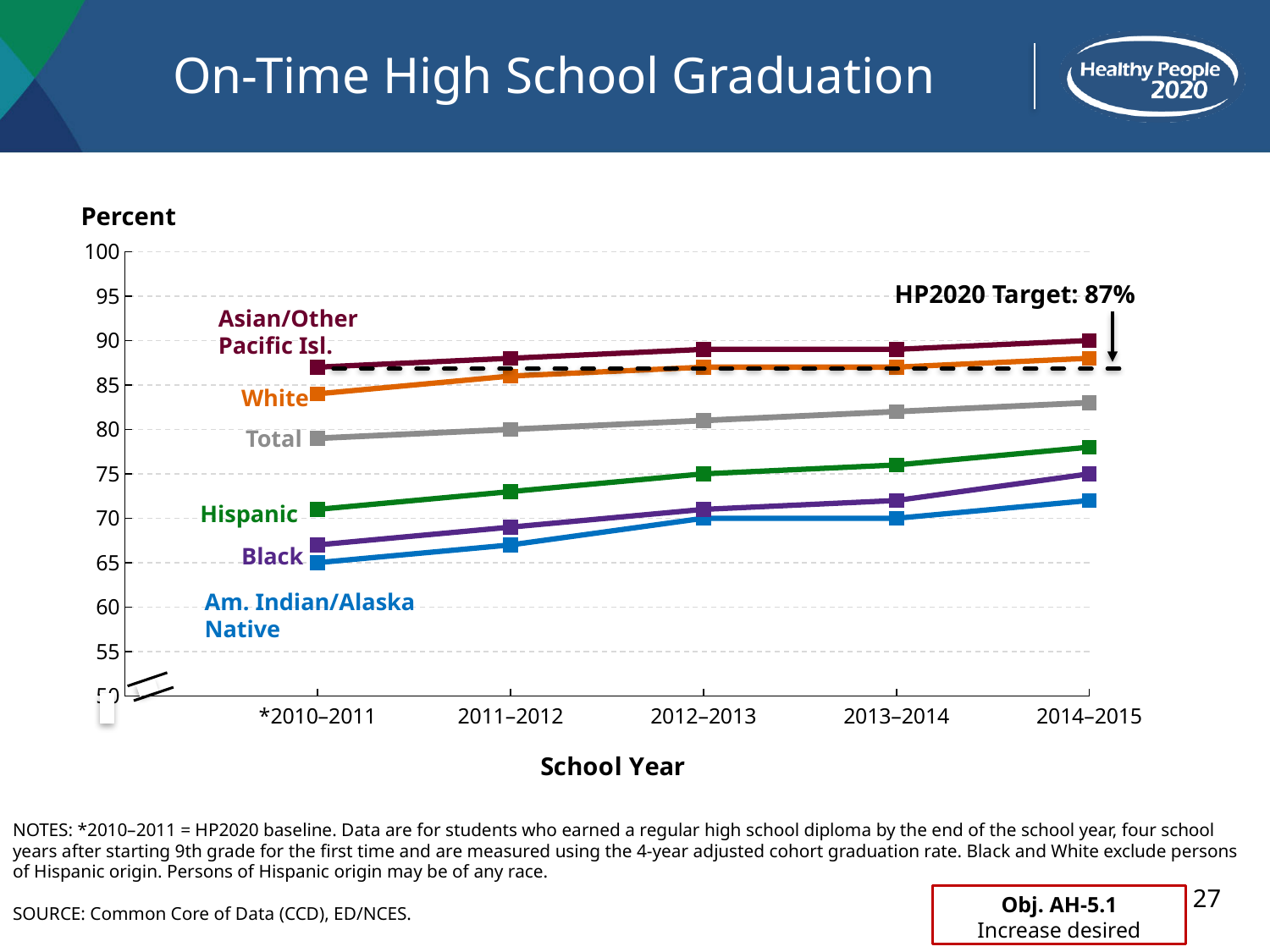
In 2010–2011, which was higher: the White rate or the Total rate? White Which group had the highest on-time graduation rate in 2014–2015? Asian/Other Pacific Isl. What is the label on the y axis of the chart? Percent Is the value for Asian/Other Pacific Isl. in 2010–2011 greater or less than 90? less What kind of chart is shown on the slide? line chart Is the value for Black in 2010–2011 greater or less than 70? less Is the value for Hispanic in 2014–2015 greater or less than 75? greater How many population groups (series) are plotted on the chart? 6 Which group had the lowest on-time graduation rate in 2010–2011? Am. Indian/Alaska Native What is the HP2020 Target value shown on the chart? 87% Does the Total on-time graduation rate rise or fall from 2010–2011 to 2014–2015? rise How many school years are plotted along the x axis? 5